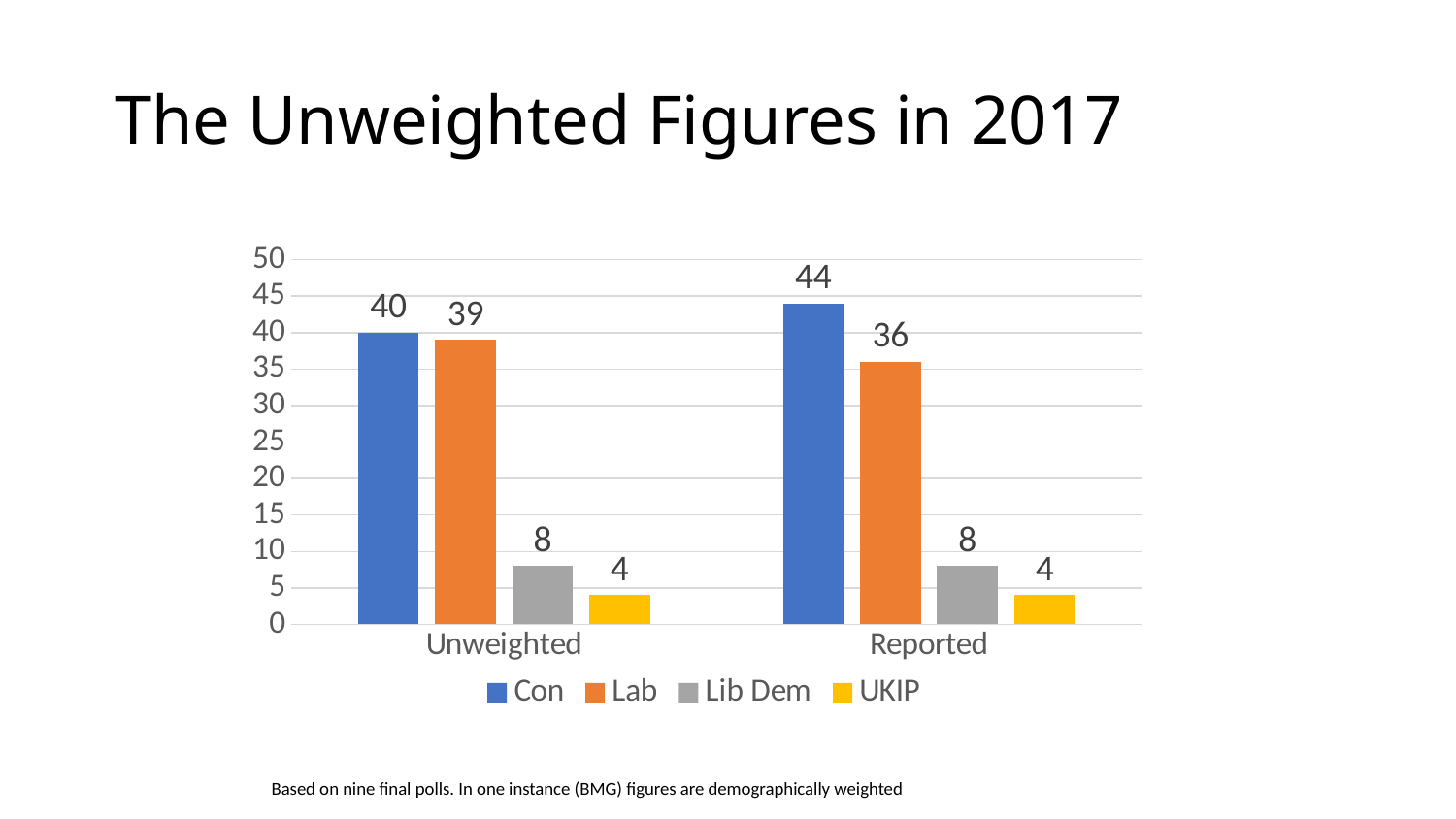
How many categories are shown on the x axis? 2 What kind of chart is shown on the slide? Bar chart What is the difference between the Con values for Reported and Unweighted? 4 What is the Con value for the Unweighted category? 40 What is the Lab value for the Reported category? 36 What is the UKIP value for the Unweighted category? 4 Which is larger, the Lab value for Unweighted or the Lab value for Reported? Unweighted What is the title of the slide? The Unweighted Figures in 2017 How many series does the legend list? 4 Which series has the highest value in the Reported category? Con Which series has the lowest value in the Unweighted category? UKIP What is the difference between the Con and Lab values in the Reported category? 8